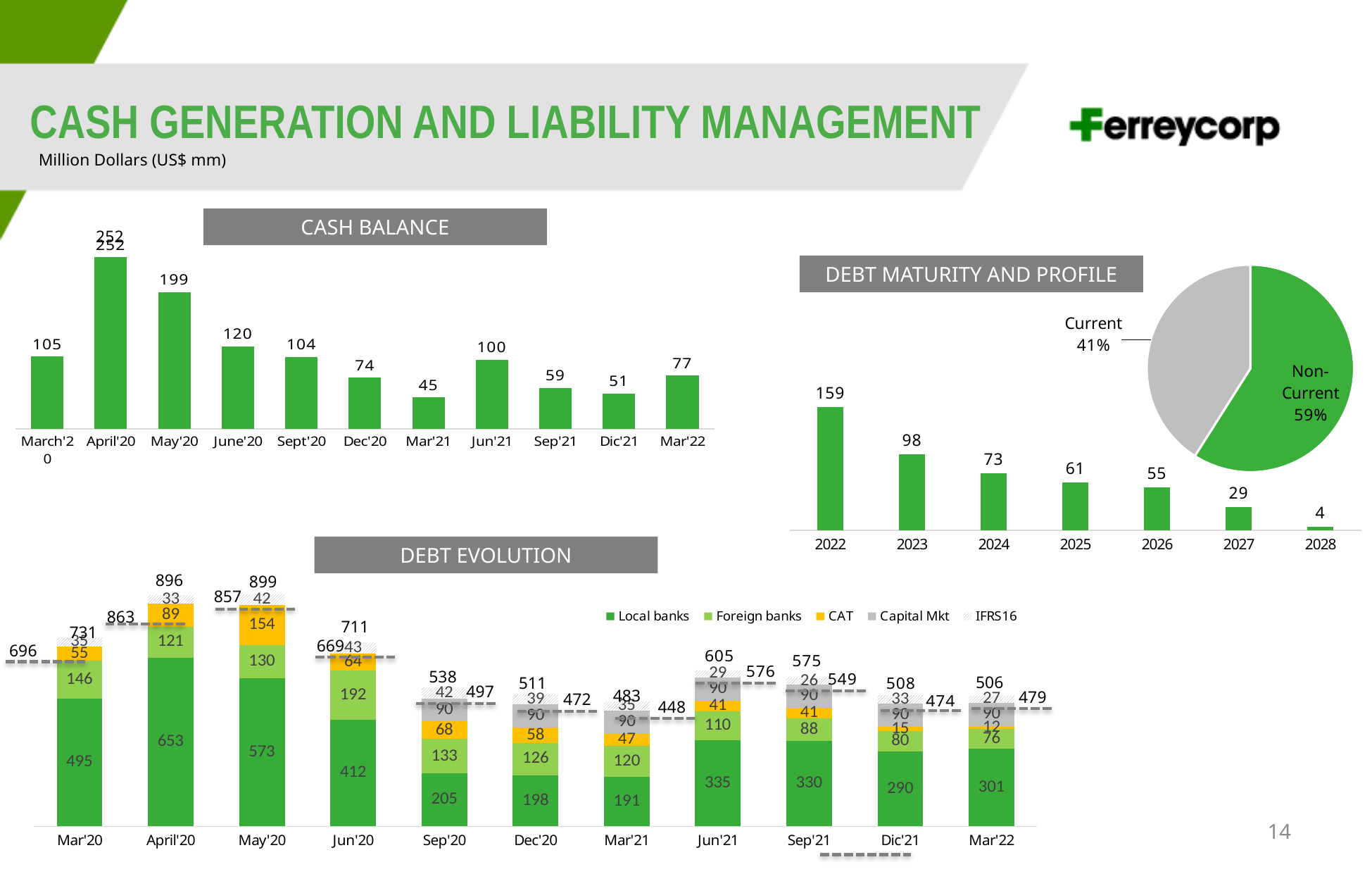
In the Debt Maturity and Profile bar chart, do the values rise or fall from 2022 to 2028? fall In the Debt Evolution chart, what is the CAT value for May'20? 154 In the Cash Balance chart, what is the difference between the April'20 and May'20 values? 53 In the Cash Balance chart, which period has the lowest cash balance? Mar'21 In the Debt Maturity and Profile bar chart, what is the value for 2024? 73 In the Debt Evolution chart, how many series does the legend list? 5 In the Cash Balance chart, what is the value for April'20? 252 In the Debt Maturity and Profile bar chart, which year has the highest value? 2022 In the Debt Maturity and Profile pie chart, what share is Non-Current? 59% In the Debt Evolution chart, what is the Local banks value for April'20? 653 In the Debt Evolution chart, which is larger: the Local banks value for Jun'21 or for Sep'21? Jun'21 In the Cash Balance chart, how many periods are shown? 11